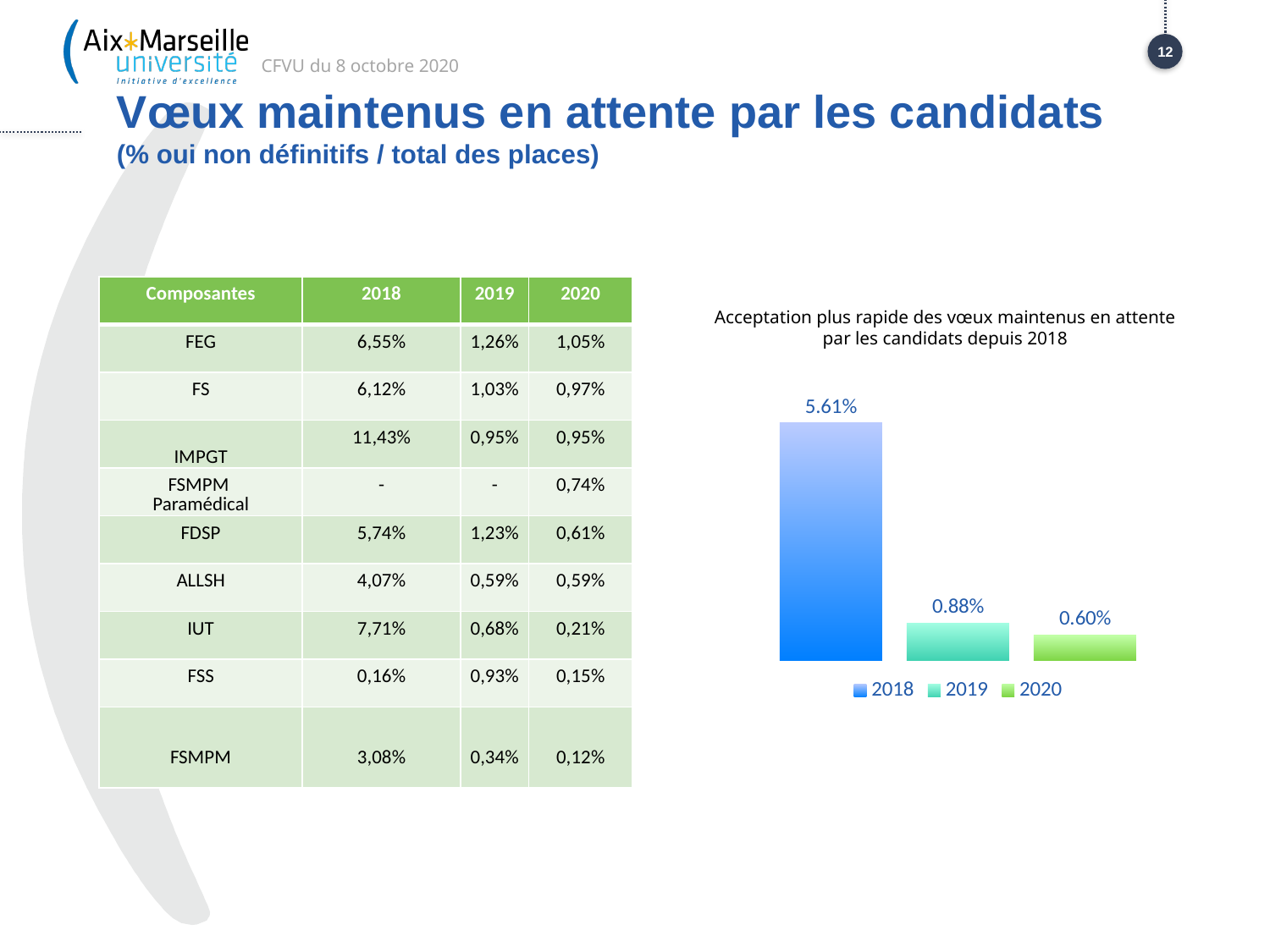
How many entries does the chart's legend list? 3 What value does the chart show for 2020? 0.60% Which year has the lowest value in the chart? 2020 What is the difference between the 2019 and 2020 values in the chart? 0.28% Which year has the highest value in the chart? 2018 What value does the chart show for 2018? 5.61% Do the values in the chart rise or fall from 2018 to 2020? Fall How many bars are plotted in the chart? 3 What value does the chart show for 2019? 0.88% What is the difference between the 2018 and 2019 values in the chart? 4.73% What kind of chart is shown on the slide? Bar chart Which is larger in the chart, the value for 2019 or the value for 2020? 2019